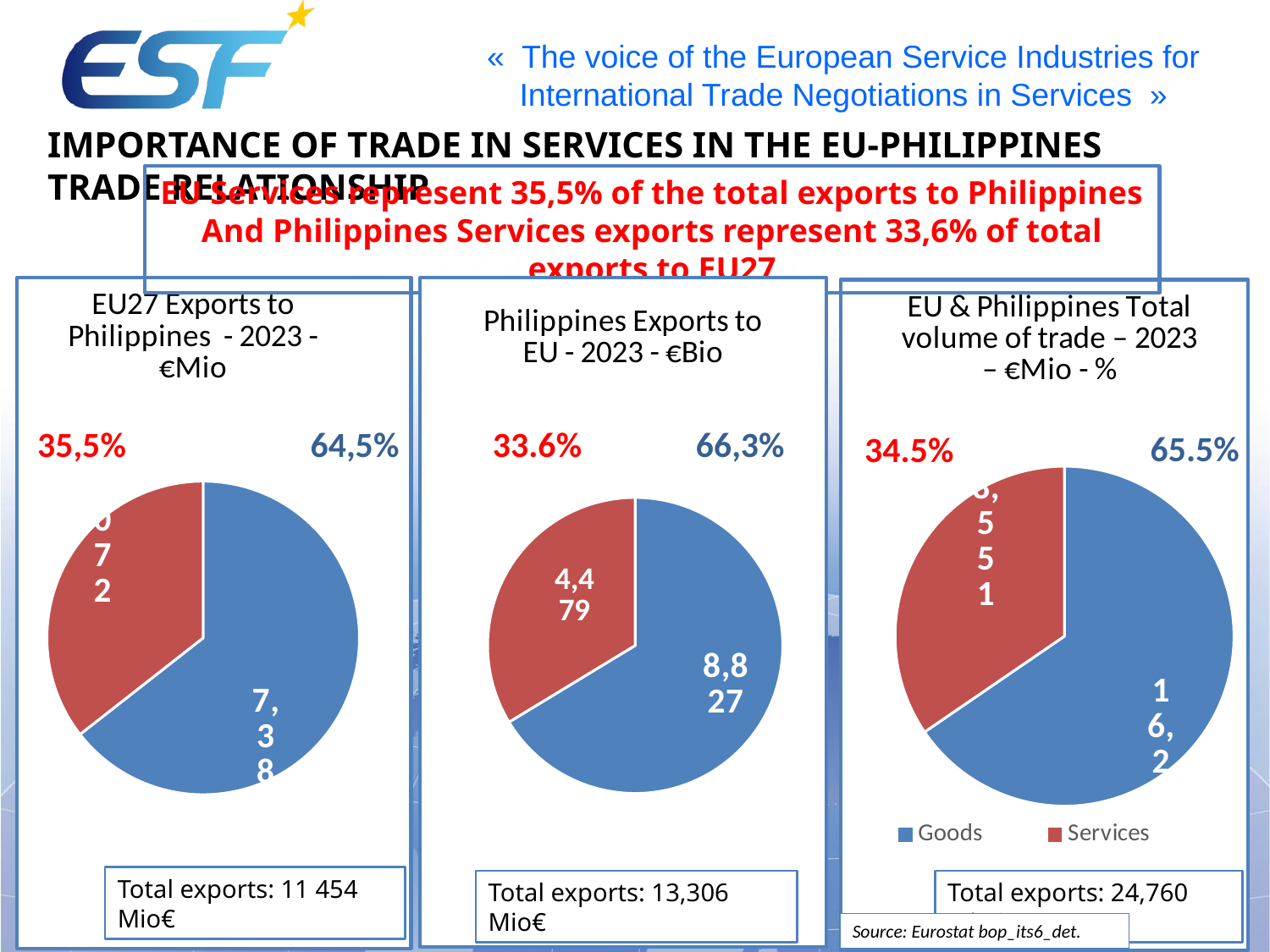
In the 'Philippines Exports to EU - 2023 - €Bio' chart, what share of exports is services? 33.6% In the 'EU & Philippines Total volume of trade – 2023' chart, what share is goods? 65.5% In the 'Philippines Exports to EU - 2023 - €Bio' chart, what is the value labelled on the services slice? 4,479 In the 'Philippines Exports to EU - 2023 - €Bio' chart, what is the value labelled on the goods slice? 8,827 In the 'EU & Philippines Total volume of trade – 2023' chart, which colour represents Goods in the legend? Blue In the 'EU27 Exports to Philippines - 2023 - €Mio' chart, which is larger, goods or services? Goods In the 'EU & Philippines Total volume of trade – 2023' chart, what share is services? 34.5% What kind of chart is used in the 'EU27 Exports to Philippines - 2023 - €Mio' chart? Pie chart How many entries does the legend of the 'EU & Philippines Total volume of trade – 2023' chart list? 2